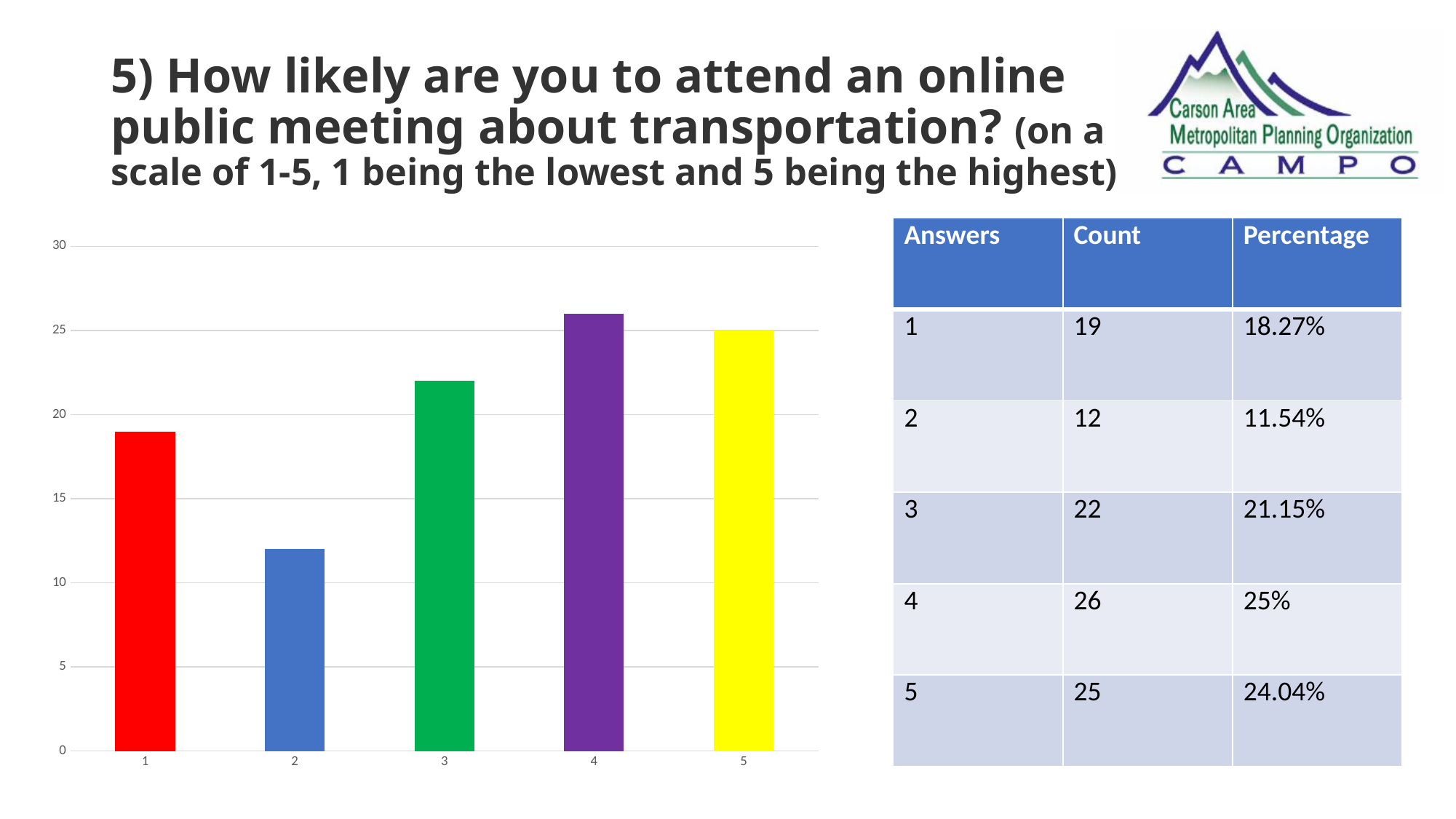
What is the count for answer 1? 19 What is the difference between the count for answer 4 and the count for answer 1? 7 Is the value for answer 1 greater or less than 20? less What is the count for answer 3? 22 Which has a larger count, answer 3 or answer 2? answer 3 Which answer has the lowest count? 2 What percentage corresponds to answer 5? 24.04% What colour is the bar for answer 5? yellow What percentage corresponds to answer 4? 25% How many categories are shown on the x axis of the chart? 5 What type of chart is shown on the slide? bar chart Which answer has the highest count? 4